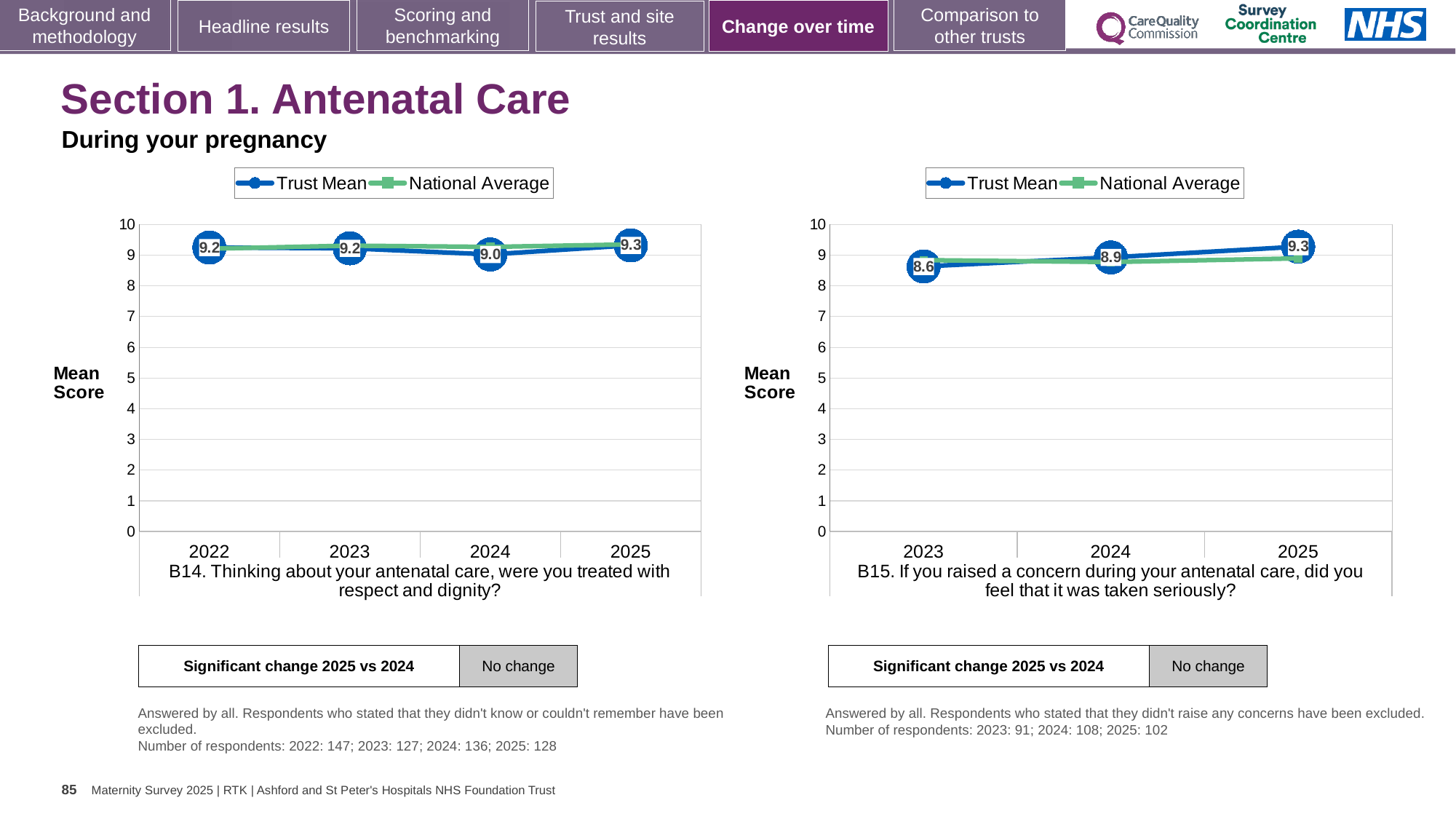
In the B14 chart on the left, what is the difference between the Trust Mean for 2025 and for 2024? 0.3 How many series does the legend of the B15 chart on the right list? 2 What type of chart is the B14 chart on the left? Line chart How many years are plotted on the x axis of the B14 chart on the left? 4 In the B15 chart on the right, which year has the highest Trust Mean? 2025 In the B15 chart on the right, by how much did the Trust Mean increase from 2023 to 2025? 0.7 In the B15 chart on the right, is the Trust Mean higher in 2024 or in 2023? 2024 In the B14 chart on the left, which year has the lowest Trust Mean? 2024 In the B15 chart on the right, is the National Average for 2023 greater or less than 8? greater In the B15 chart on the right, does the Trust Mean rise or fall from 2023 to 2025? Rise In the B15 chart on the right, what is the Trust Mean for 2023? 8.6 In the B14 chart on the left, what is the Trust Mean for 2024? 9.0